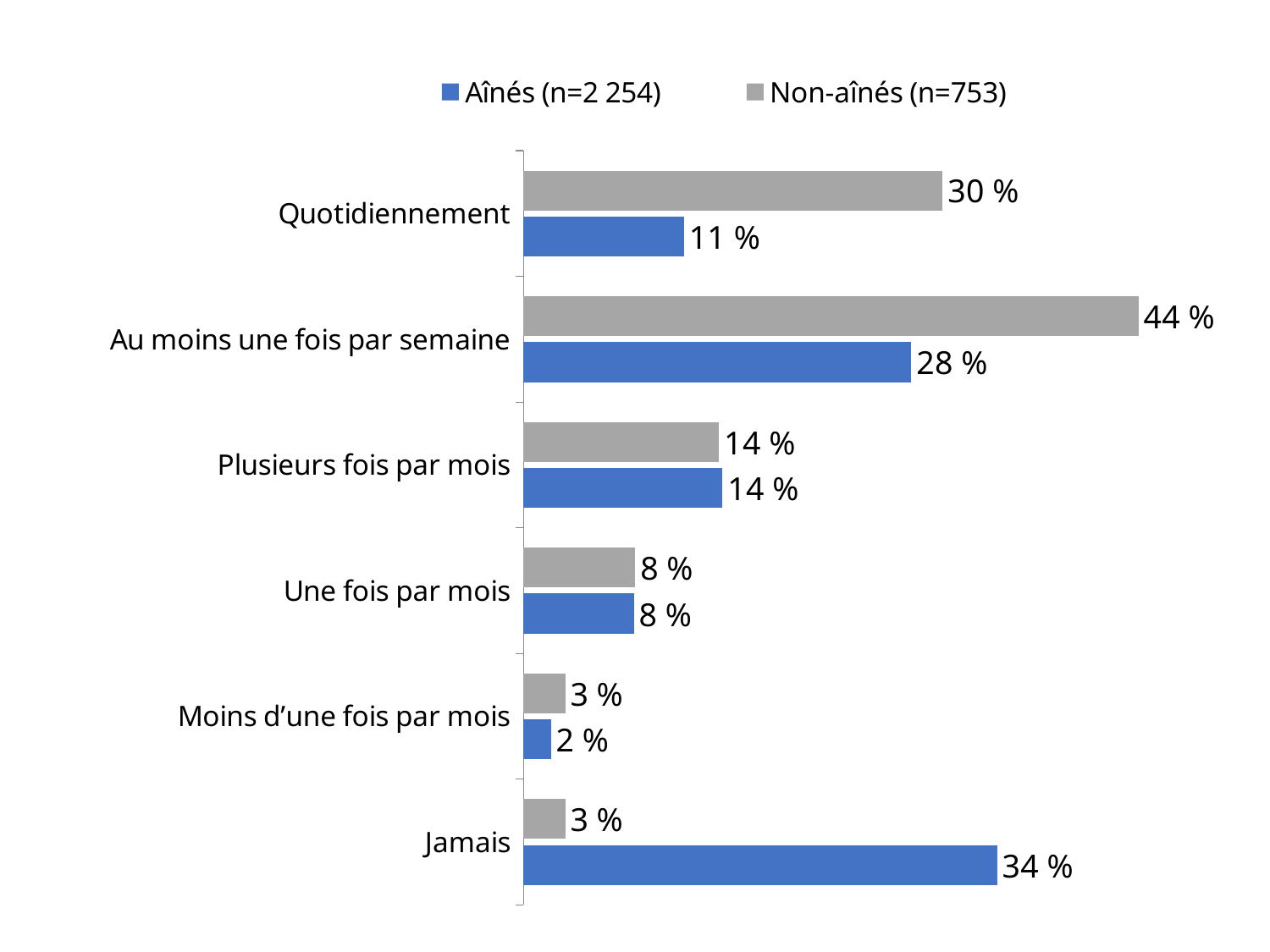
What is the value for Aînés (n=2 254) in the Quotidiennement category? 11 % What is the difference between the Non-aînés (n=753) and Aînés (n=2 254) values for Quotidiennement? 19 % Which colour represents the Non-aînés (n=753) series? Grey What is the value for Aînés (n=2 254) in the Jamais category? 34 % Which series has the larger value for Au moins une fois par semaine? Non-aînés (n=753) What is the difference between the Aînés (n=2 254) and Non-aînés (n=753) values for Jamais? 31 % How many categories are shown on the chart? 6 What kind of chart is shown on the slide? Bar chart Which category has the highest value for Non-aînés (n=753)? Au moins une fois par semaine How many series does the legend list? 2 What is the value for Non-aînés (n=753) in the Au moins une fois par semaine category? 44 % Which category has the lowest value for Aînés (n=2 254)? Moins d’une fois par mois